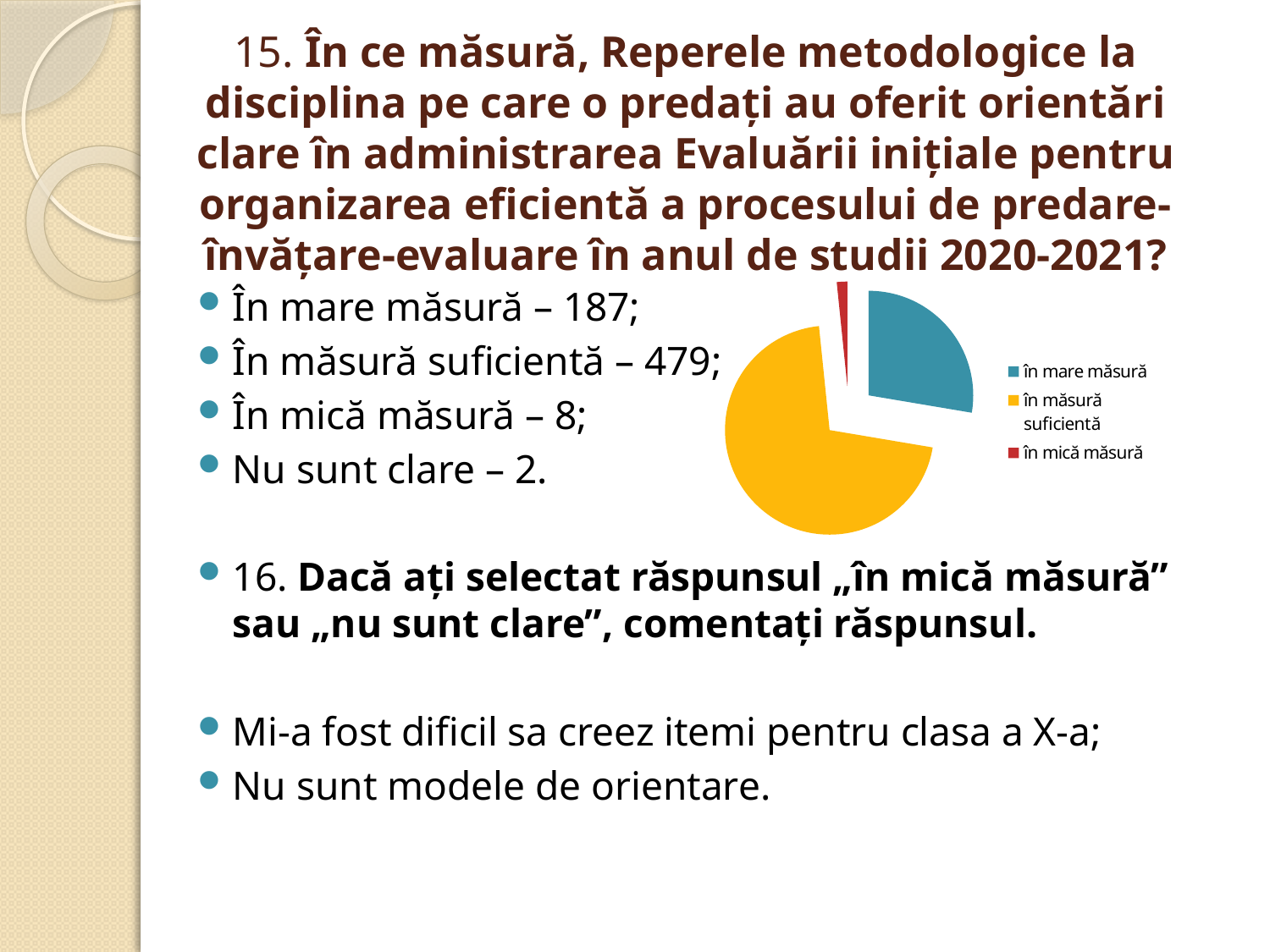
What colour represents "în mică măsură" in the pie chart? red According to the slide, what is the value for "În măsură suficientă"? 479 What is the difference between the values for "În măsură suficientă" and "În mare măsură"? 292 Which category has the largest slice of the pie? în măsură suficientă How many entries does the chart's legend list? 3 Which legend category has the smallest slice of the pie? în mică măsură Which slice is larger: "în mare măsură" or "în mică măsură"? în mare măsură According to the slide, what is the value for "În mare măsură"? 187 According to the slide, what is the value for "În mică măsură"? 8 Which slice is larger: "în mare măsură" or "în măsură suficientă"? în măsură suficientă What colour represents "în măsură suficientă" in the pie chart? yellow What kind of chart is shown on the slide? pie chart